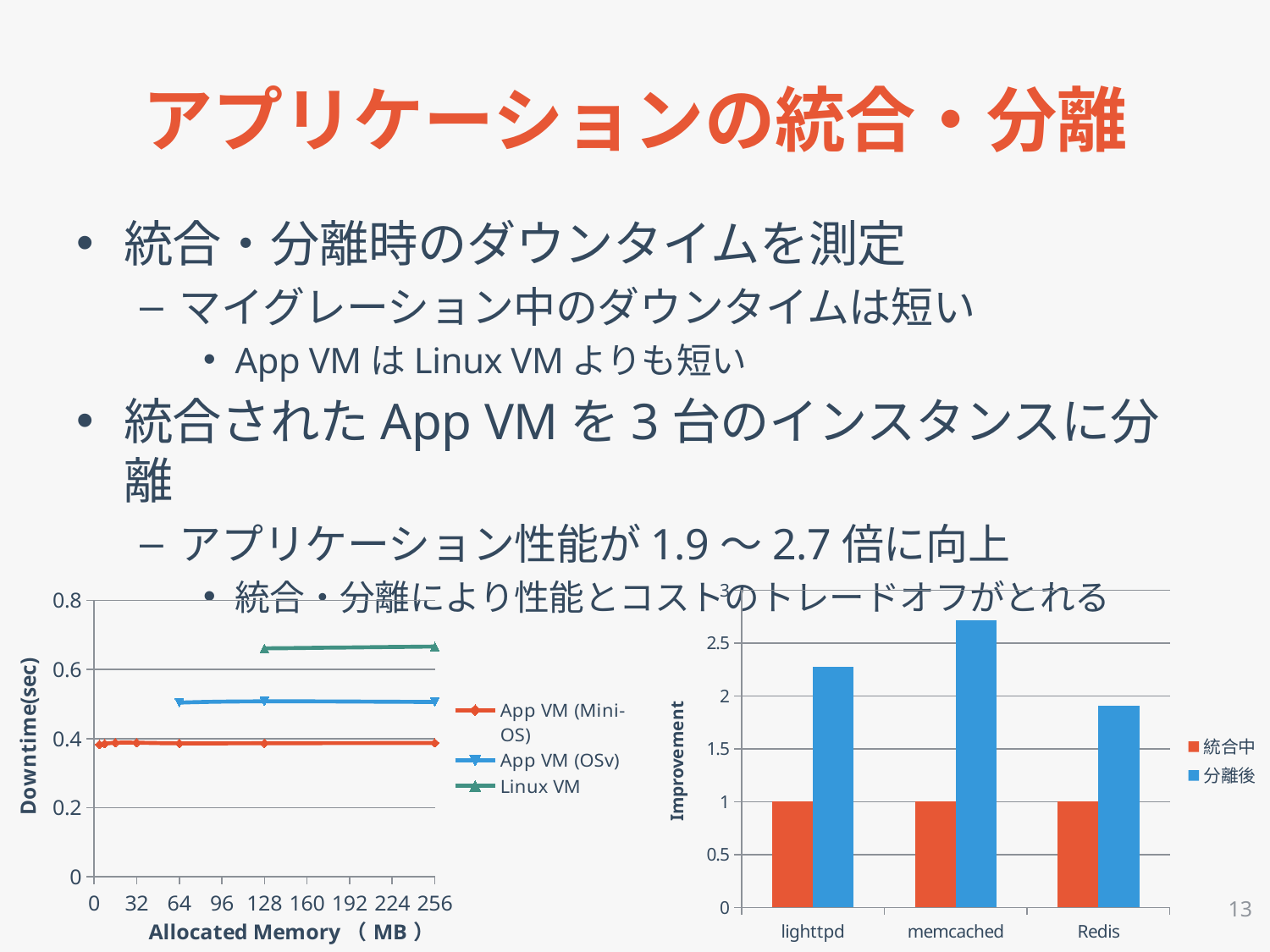
In the left Downtime chart, is the downtime for App VM (OSv) at 128 MB greater or less than 0.4? greater In the left Downtime chart, is the downtime for Linux VM at 256 MB greater or less than 0.6? greater In the right Improvement chart, what is the 統合中 value for lighttpd? 1 In the right Improvement chart, how many categories are shown on the x axis? 3 In the right Improvement chart, which category has the lowest 分離後 value? Redis In the right Improvement chart, is the 分離後 value for memcached greater or less than 2.5? greater In the left Downtime chart, which series has the highest downtime? Linux VM In the right Improvement chart, which category has the highest 分離後 value? memcached In the left Downtime chart, which series has the lowest downtime? App VM (Mini-OS) In the left Downtime chart, how many series does the legend list? 3 What kind of chart is the right chart showing Improvement for lighttpd, memcached and Redis? bar chart What kind of chart is the left chart showing Downtime(sec) against Allocated Memory? line chart